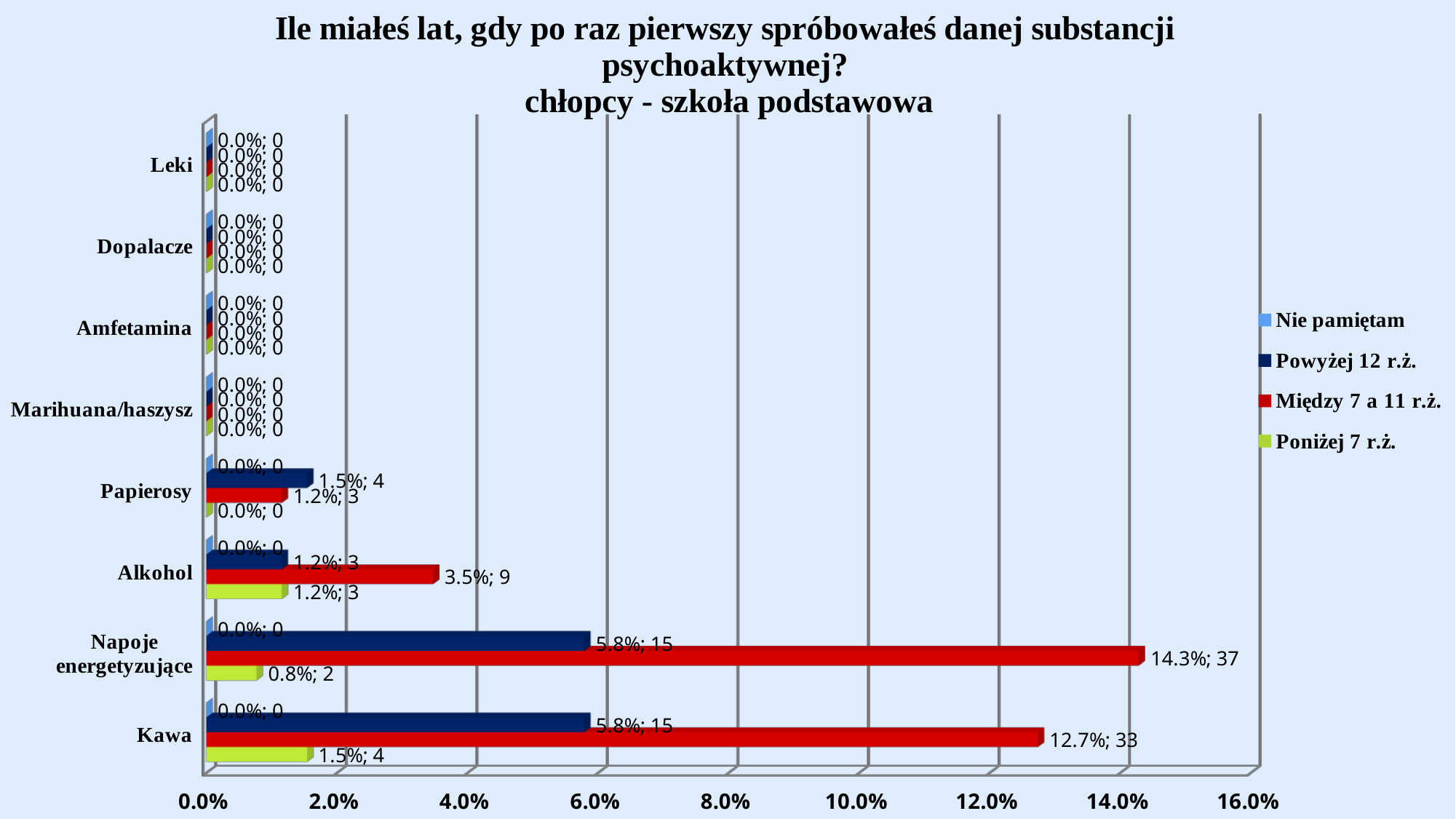
Which category has the highest value in the Między 7 a 11 r.ż. series? Napoje energetyzujące What kind of chart is shown on the slide? bar chart How many series does the legend list? 4 Which is larger for Alkohol: the Między 7 a 11 r.ż. value or the Powyżej 12 r.ż. value? Między 7 a 11 r.ż. What is the value for Kawa in the Poniżej 7 r.ż. series? 1.5%; 4 Which legend entry is shown in red? Między 7 a 11 r.ż. Is the value for Kawa in the Między 7 a 11 r.ż. series greater or less than 12.0%? greater What is the difference in percentage between Napoje energetyzujące and Kawa in the Między 7 a 11 r.ż. series? 1.6% What is the value for Napoje energetyzujące in the Między 7 a 11 r.ż. series? 14.3%; 37 How many substance categories are shown on the y axis? 8 What is the value for Papierosy in the Powyżej 12 r.ż. series? 1.5%; 4 What is the value for Alkohol in the Między 7 a 11 r.ż. series? 3.5%; 9